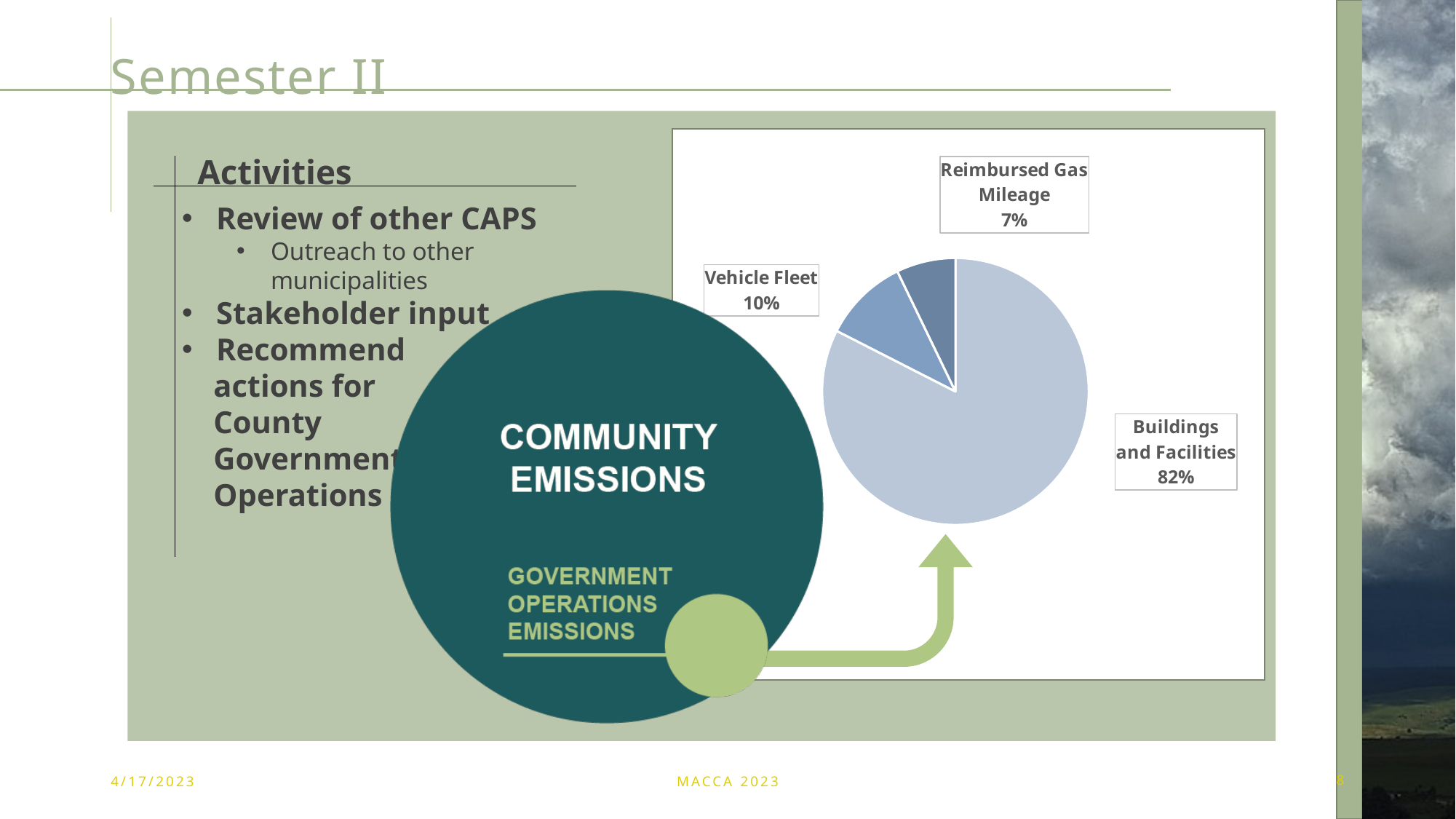
What share of the pie does Buildings and Facilities represent? 82% Which is larger, the Vehicle Fleet slice or the Reimbursed Gas Mileage slice? Vehicle Fleet What is the difference in percentage points between Buildings and Facilities and Vehicle Fleet? 72 How many slices does the pie chart have? 3 What is the difference in percentage points between Vehicle Fleet and Reimbursed Gas Mileage? 3 What kind of chart is shown on the slide? pie chart Which category has the smallest slice of the pie? Reimbursed Gas Mileage Which category has the largest slice of the pie? Buildings and Facilities Is the share for Buildings and Facilities greater or less than 50%? greater What share of the pie does Reimbursed Gas Mileage represent? 7% What share of the pie does Vehicle Fleet represent? 10% Which slice of the pie is drawn in the darkest blue? Reimbursed Gas Mileage